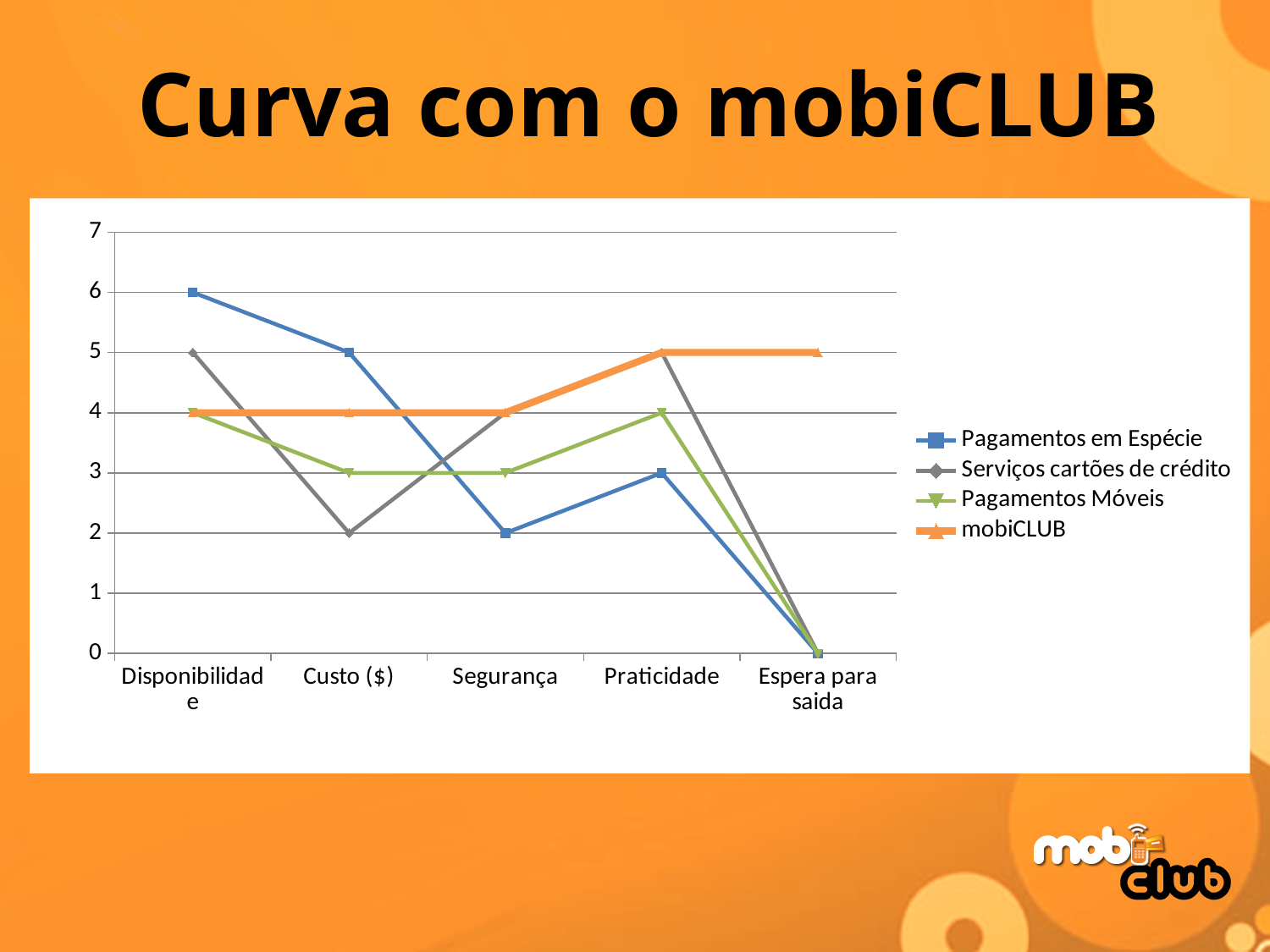
What is the difference between Pagamentos em Espécie and Pagamentos Móveis at Segurança? 1 What kind of chart is shown on the slide? line chart What is the value for Pagamentos Móveis at Praticidade? 4 How many series does the legend list? 4 What is the value for mobiCLUB at Espera para saida? 5 Which is larger at Custo ($): Pagamentos em Espécie or Serviços cartões de crédito? Pagamentos em Espécie What is the value for Serviços cartões de crédito at Custo ($)? 2 Which category has the highest value for Pagamentos em Espécie? Disponibilidade What is the value for Pagamentos em Espécie at Disponibilidade? 6 How many categories are shown on the x axis? 5 Which category has the lowest value for Serviços cartões de crédito? Espera para saida Does the mobiCLUB series rise or fall from Segurança to Praticidade? rise